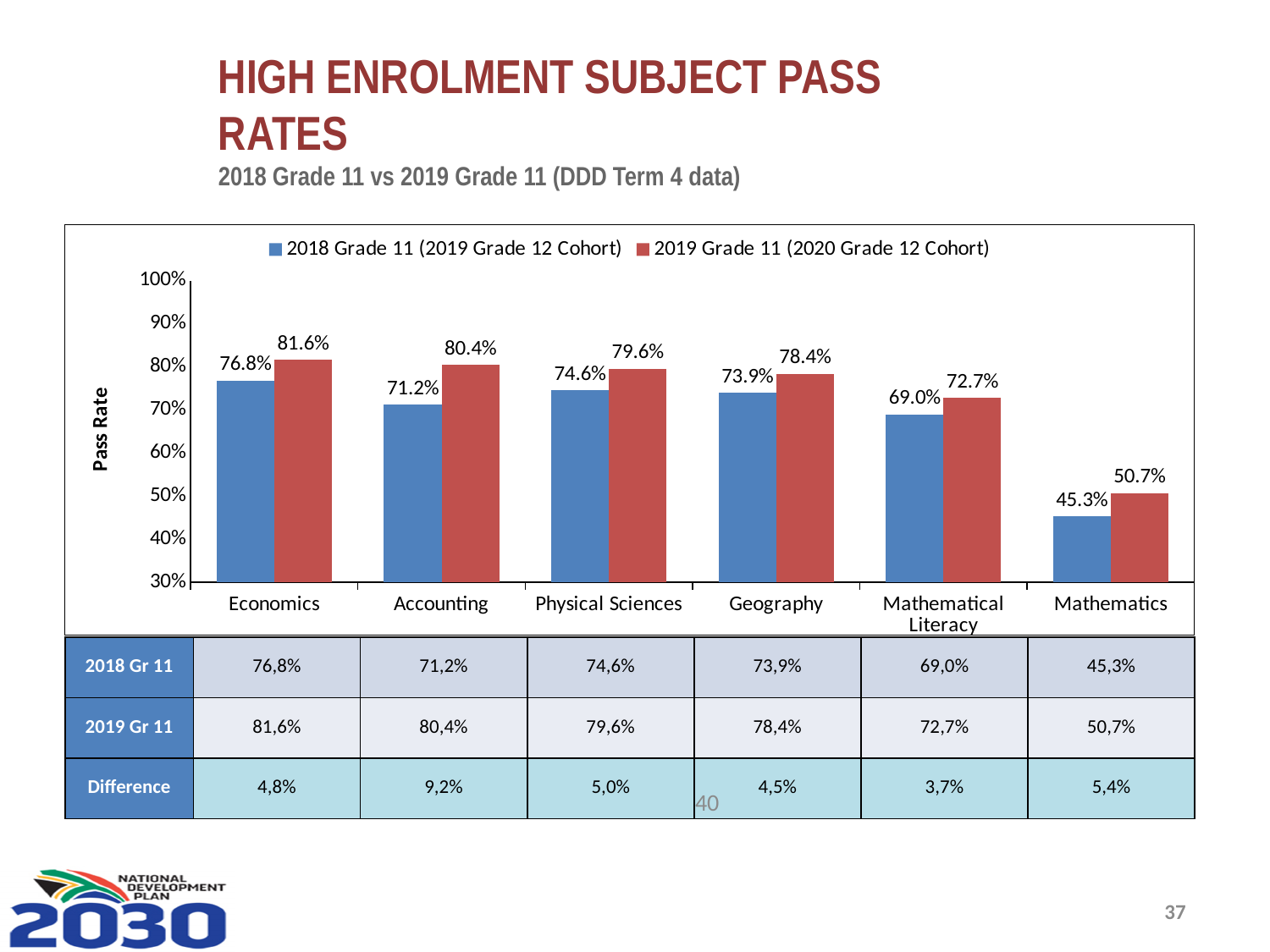
How many series does the legend list? 2 Which is larger: the 2018 Grade 11 pass rate for Physical Sciences or for Geography? Physical Sciences What is the 2019 Grade 11 pass rate for Accounting? 80.4% Which subject has the lowest 2019 Grade 11 pass rate? Mathematics What is the 2018 Grade 11 pass rate for Mathematical Literacy? 69.0% What is the difference between the 2019 and 2018 Grade 11 pass rates for Accounting? 9.2% Which subject has the highest 2019 Grade 11 pass rate? Economics What is the difference between the 2019 and 2018 Grade 11 pass rates for Mathematics? 5.4% What kind of chart is shown on the slide? Bar chart Is the 2018 Grade 11 pass rate for Mathematics greater or less than 50%? less How many subjects are shown on the chart? 6 What is the 2018 Grade 11 pass rate for Economics? 76.8%